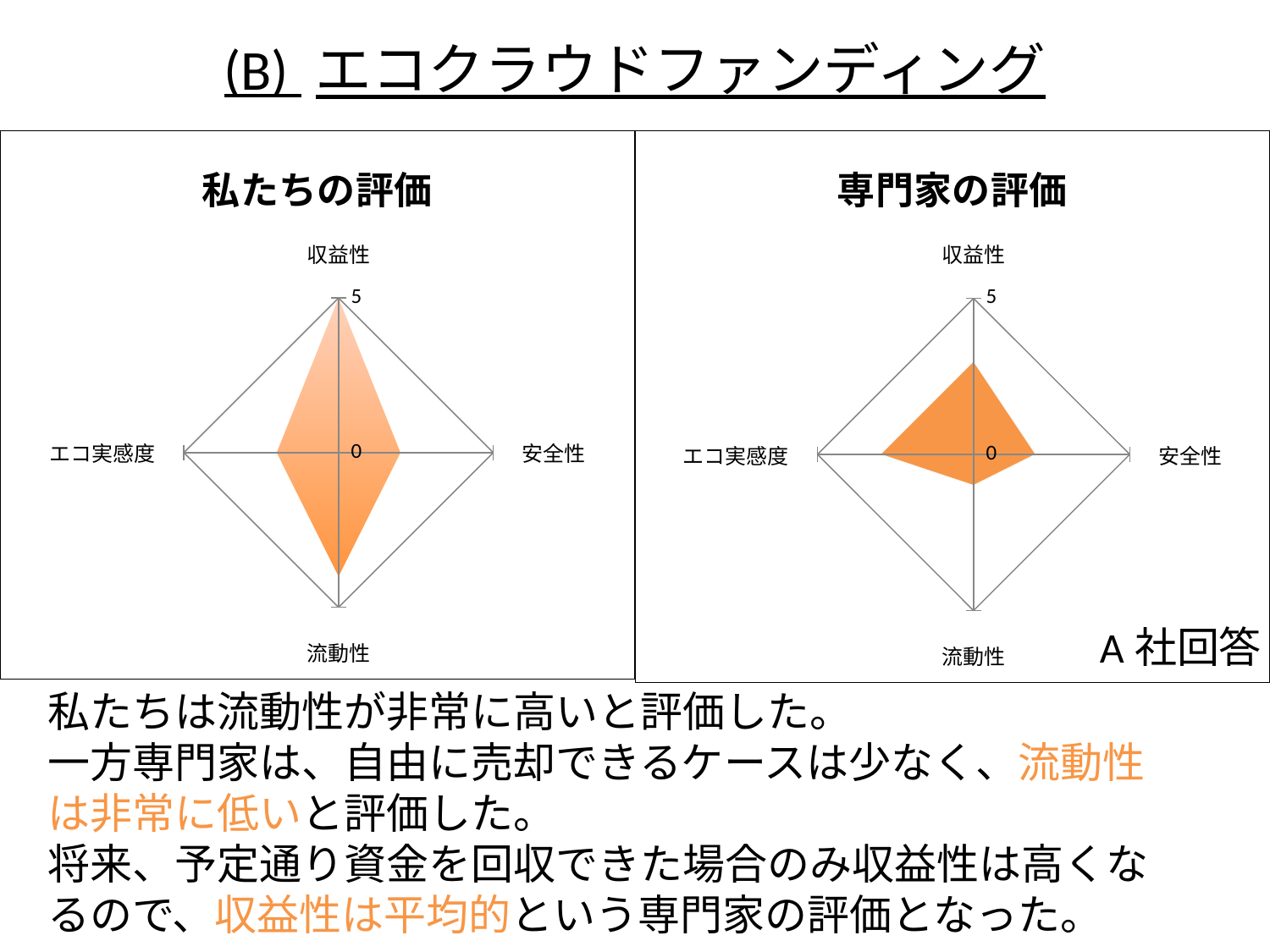
In the 私たちの評価 chart, which axis has the highest value? 収益性 In the 専門家の評価 chart, which axis has the lowest value? 流動性 What is the maximum value shown on the radar chart axes? 5 In the 私たちの評価 chart, what is the value for 収益性? 5 What kind of chart is used for 私たちの評価 and 専門家の評価? Radar chart In the 専門家の評価 chart, which is larger, 安全性 or 流動性? 安全性 In the 専門家の評価 chart, is the value for 収益性 greater or less than 5? less What are the titles of the two radar charts on the slide? 私たちの評価 and 専門家の評価 Which chart shows a higher value for 流動性, 私たちの評価 or 専門家の評価? 私たちの評価 How many evaluation axes does each radar chart have? 4 Which chart shows a higher value for 収益性, 私たちの評価 or 専門家の評価? 私たちの評価